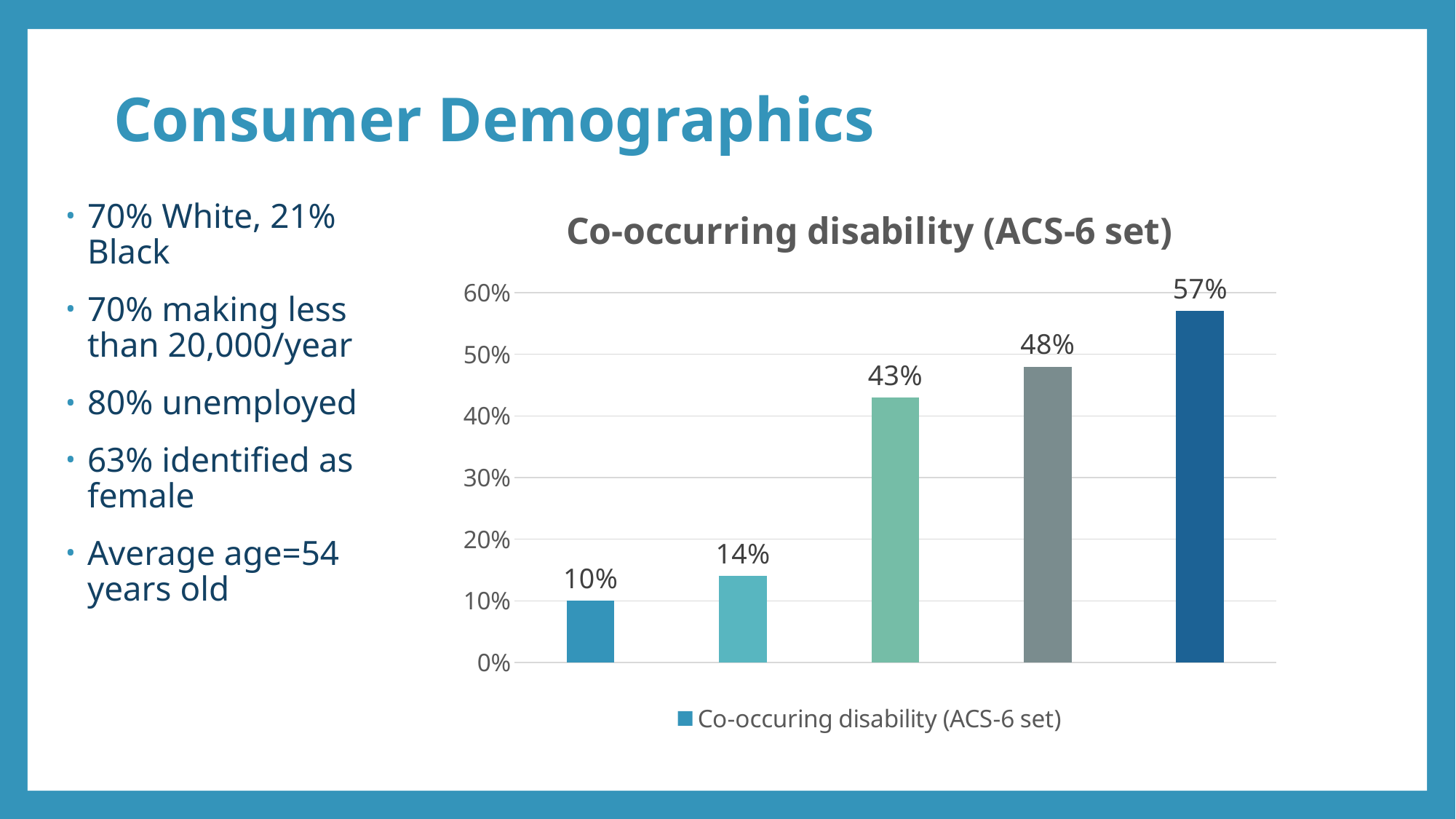
What is the value of the middle (third) bar in the chart? 43% What is the value of the leftmost bar in the chart? 10% What is the difference between the rightmost bar and the leftmost bar? 47% What is the highest value shown in the chart? 57% Do the bar values rise or fall from left to right across the chart? rise What type of chart is shown on the slide? bar chart What is the lowest value shown in the chart? 10% What is the title of the chart? Co-occurring disability (ACS-6 set) What is the value of the rightmost bar in the chart? 57% What is the value of the second bar from the left in the chart? 14% How many bars are plotted in the chart? 5 How many series does the chart legend list? 1